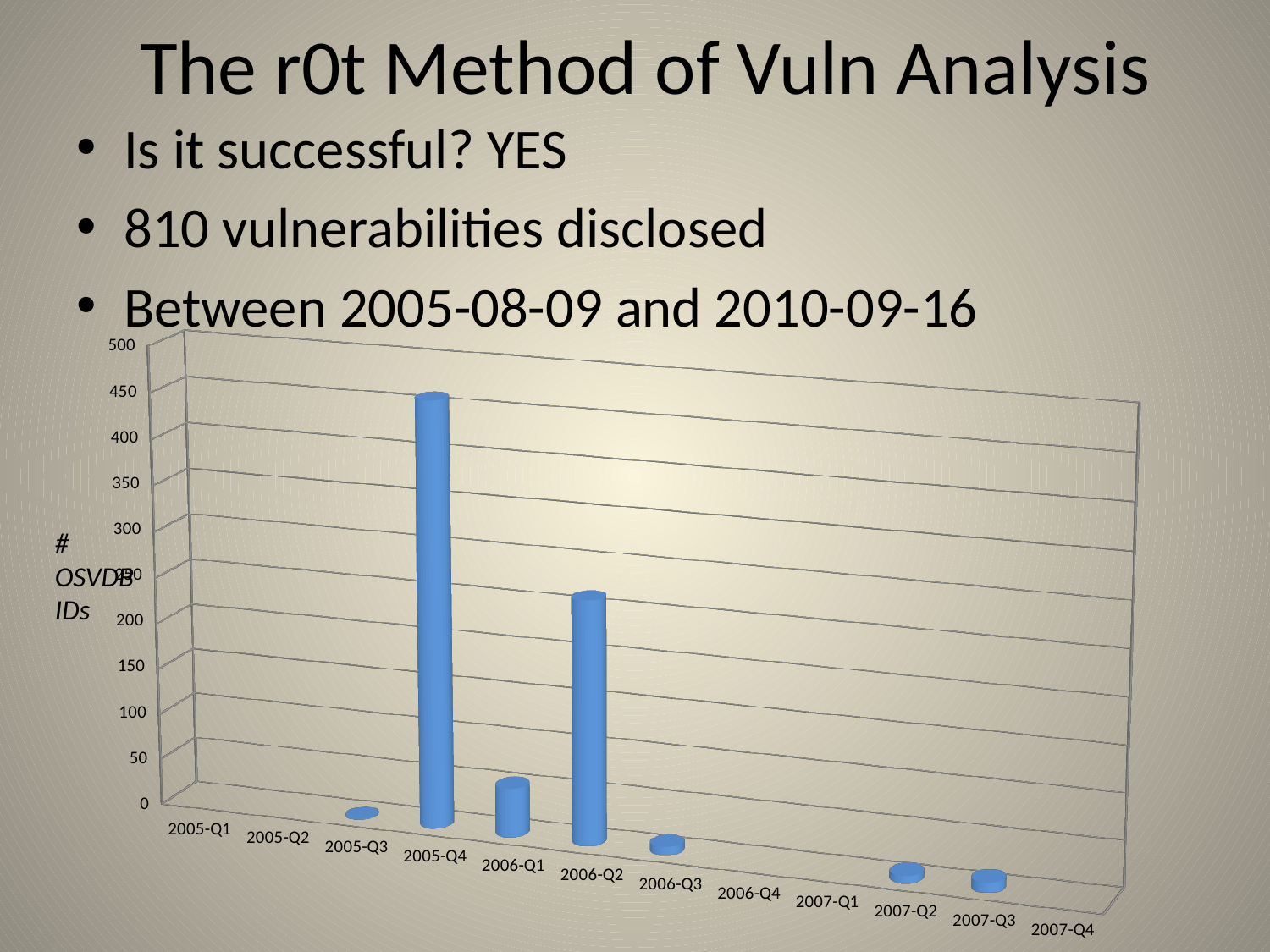
What is the highest value shown on the vertical axis of the chart? 500 Which has more OSVDB IDs, 2006-Q1 or 2006-Q2? 2006-Q2 Which has more OSVDB IDs, 2006-Q1 or 2006-Q3? 2006-Q1 What kind of chart is shown on the slide? bar chart Is the value for 2005-Q4 greater or less than 400? greater Is the value for 2005-Q3 greater or less than 50? less Is the value for 2006-Q1 greater or less than 100? less Which has more OSVDB IDs, 2005-Q4 or 2006-Q2? 2005-Q4 What is the label on the vertical axis of the chart? # OSVDB IDs How many quarters are shown on the x axis of the chart? 12 Which quarter has the highest number of OSVDB IDs? 2005-Q4